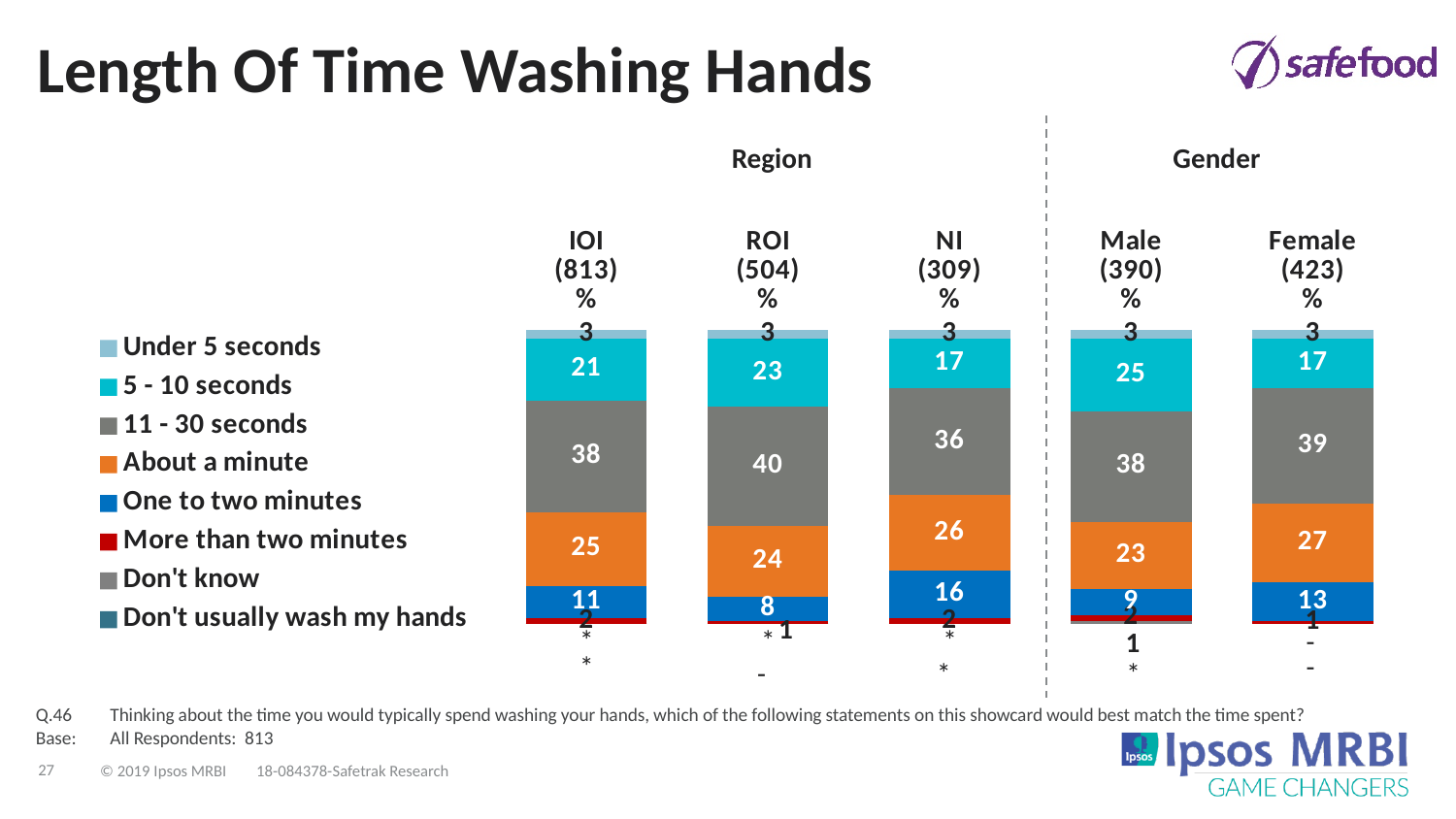
What is the value for '11 - 30 seconds' in the ROI bar? 40 What kind of chart is shown on the slide? Stacked bar chart What is the value for '5 - 10 seconds' in the Male bar? 25 What is the base size shown for the ROI bar? 504 Which bar has the lowest value for '11 - 30 seconds'? NI What is the value for 'One to two minutes' in the NI bar? 16 Which bar has the highest value for 'One to two minutes'? NI What is the difference between the '5 - 10 seconds' values for Male and Female? 8 Which is larger, the 'About a minute' value for IOI or for ROI? IOI What is the value for 'About a minute' in the Female bar? 27 How many bars (groups) are plotted in the chart? 5 How many series does the legend list? 8